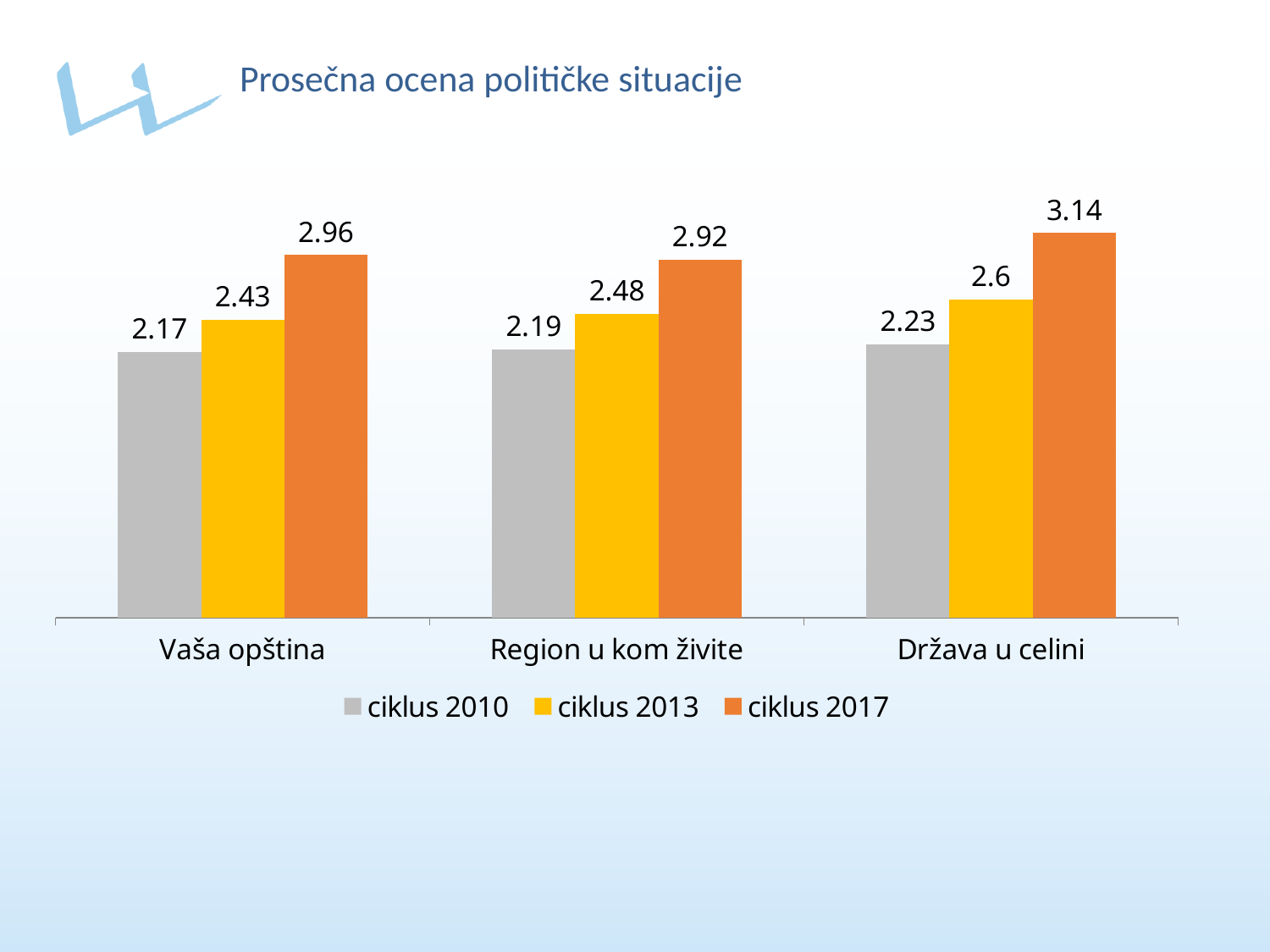
What is the difference between the ciklus 2017 values for Država u celini and Region u kom živite? 0.22 What is the value for ciklus 2017 in the Država u celini category? 3.14 Which category has the highest value for ciklus 2017? Država u celini Which category has the lowest value for ciklus 2013? Vaša opština What is the value for ciklus 2010 in the Vaša opština category? 2.17 What kind of chart is shown on the slide? bar chart How many categories are shown on the x axis? 3 How many series does the legend list? 3 What is the title of the slide? Prosečna ocena političke situacije What is the value for ciklus 2013 in the Region u kom živite category? 2.48 What is the difference between the ciklus 2017 and ciklus 2010 values for Vaša opština? 0.79 Which is larger: the ciklus 2013 value for Država u celini or the ciklus 2013 value for Vaša opština? Država u celini